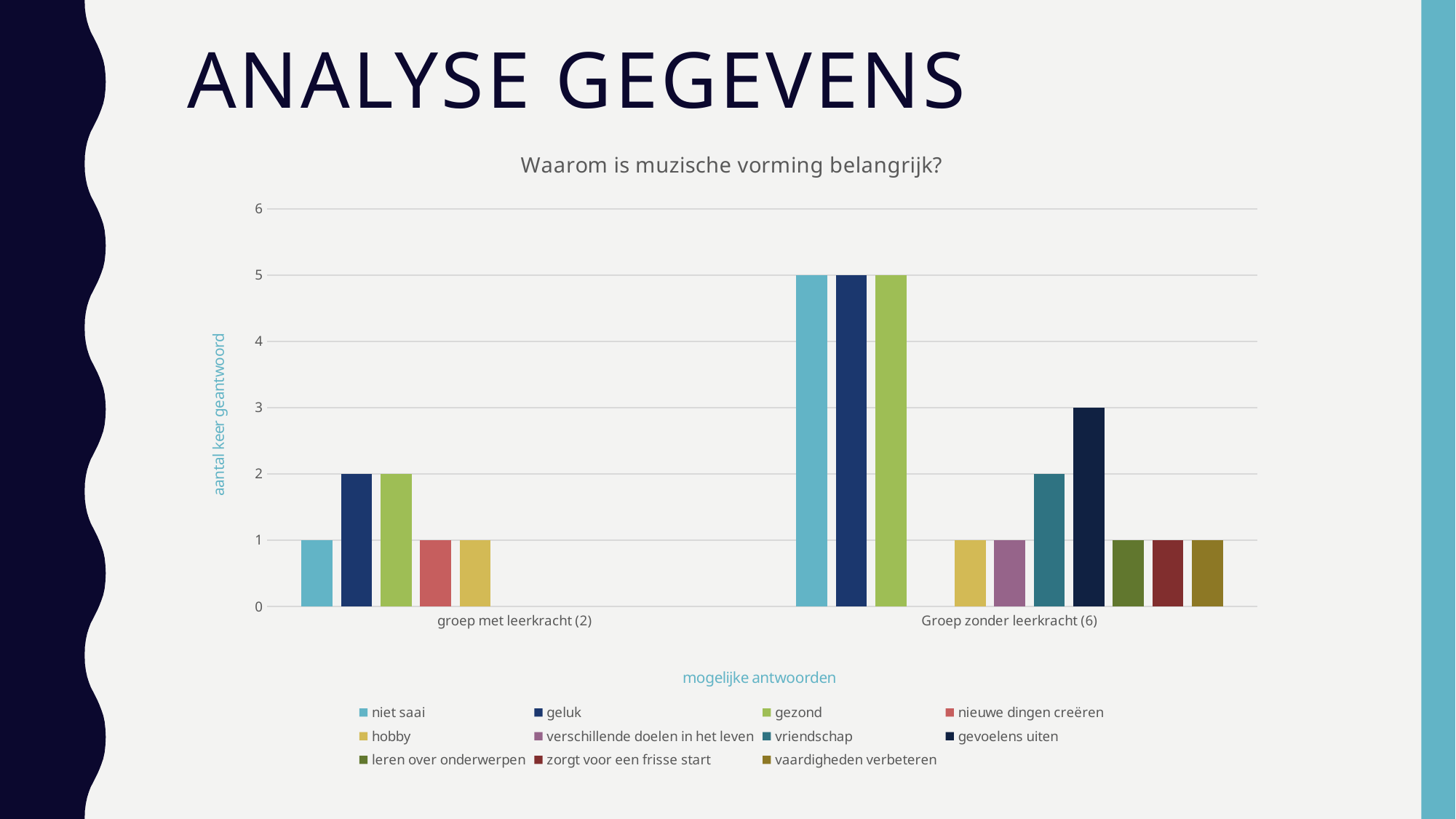
Which is larger in 'Groep zonder leerkracht (6)': 'gevoelens uiten' or 'vriendschap'? gevoelens uiten How many series does the legend list? 11 Which series has the lowest value in 'groep met leerkracht (2)' among 'geluk', 'gezond' and 'hobby'? hobby How many categories are shown on the x axis? 2 What is the value for 'vriendschap' in 'Groep zonder leerkracht (6)'? 2 What is the title of the chart? Waarom is muzische vorming belangrijk? What is the value for 'gezond' in 'groep met leerkracht (2)'? 2 What type of chart is shown on the slide? bar chart What is the value for 'geluk' in 'Groep zonder leerkracht (6)'? 5 What is the label of the y axis? aantal keer geantwoord What is the value for 'gevoelens uiten' in 'Groep zonder leerkracht (6)'? 3 What is the difference between the 'niet saai' values for 'Groep zonder leerkracht (6)' and 'groep met leerkracht (2)'? 4